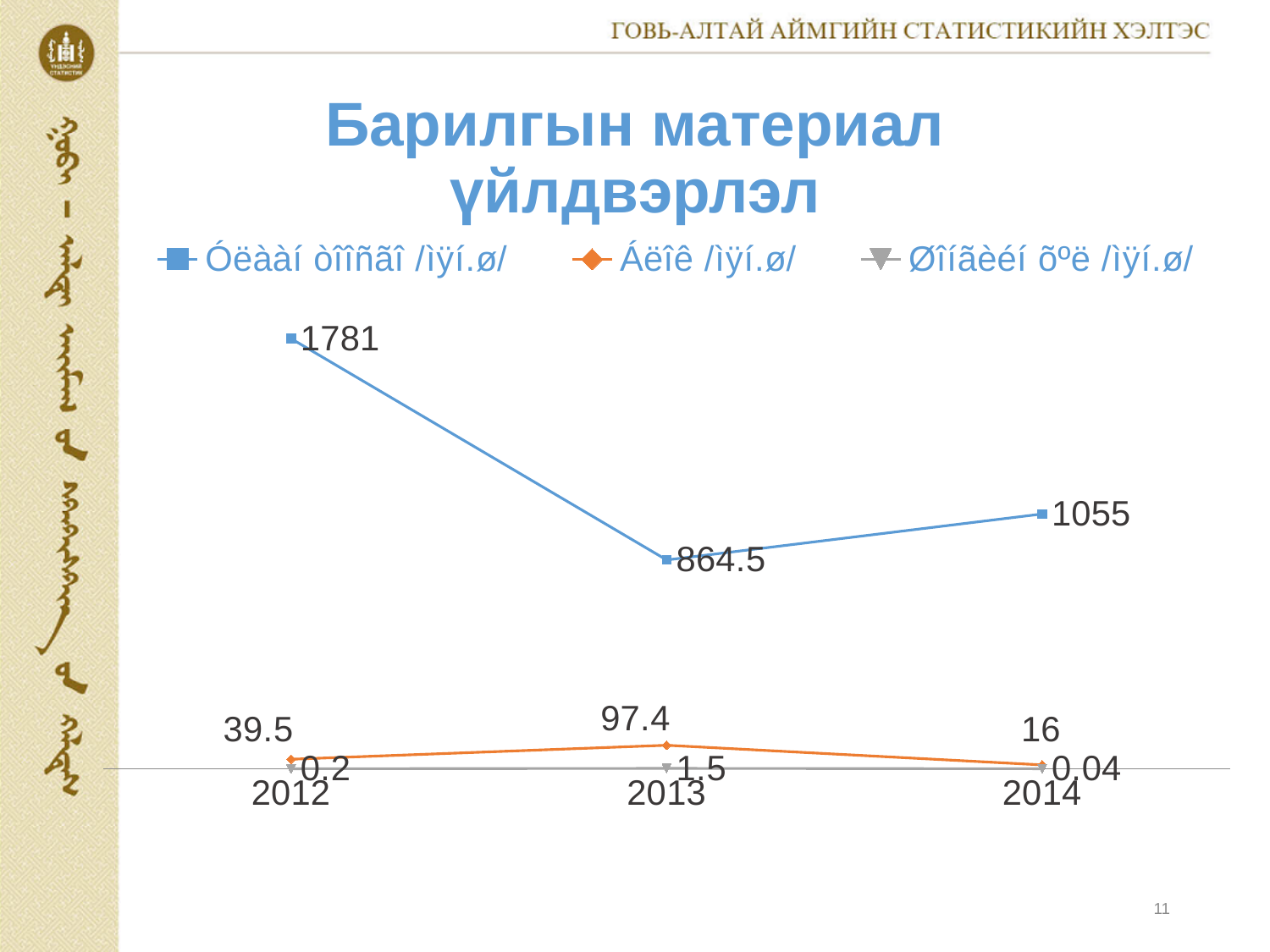
Does the blue series rise or fall from 2012 to 2013? fall What is the value of the blue series in 2012? 1781 How many series does the legend list? 3 What is the value of the blue series in 2013? 864.5 What is the difference between the blue series values in 2012 and 2014? 726 How many years are shown on the x axis? 3 What type of chart is shown on the slide? line chart Which is larger, the orange series value in 2012 or in 2014? 2012 What is the value of the orange series in 2013? 97.4 In which year is the blue series lowest? 2013 In which year is the orange series highest? 2013 What is the value of the grey series in 2014? 0.04